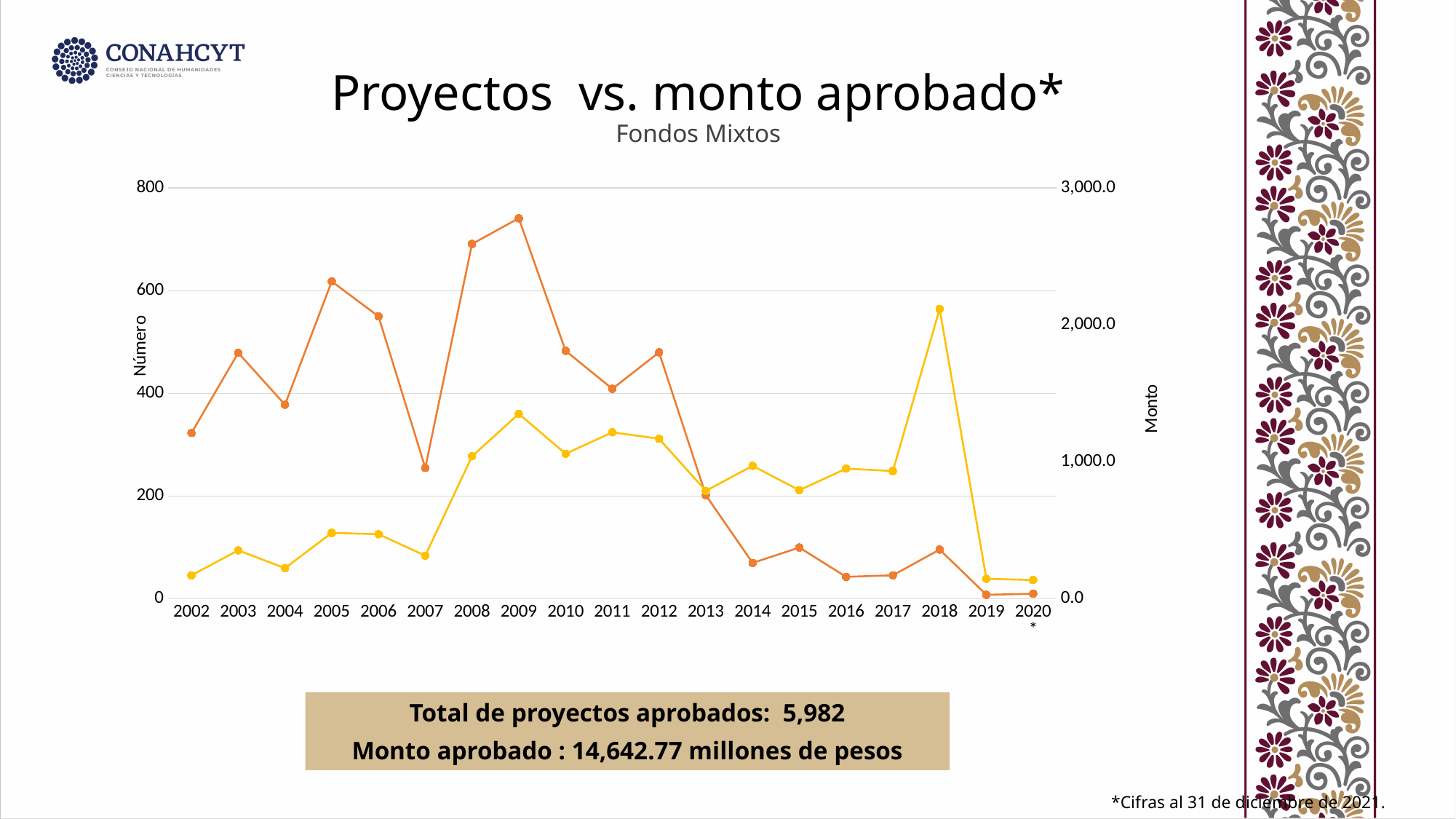
Is the value of the yellow line (Monto) for 2018 greater or less than 1,000.0? greater On the orange line (Número), which year has the higher value, 2005 or 2006? 2005 What is the label of the left vertical axis of the chart? Número Does the orange line (Número) rise or fall from 2012 to 2019? Fall In which year does the orange line (Número) reach its lowest point? 2019 What kind of chart is shown on the slide? Line chart Is the value of the orange line (Número) for 2009 greater or less than 600? greater Is the value of the yellow line (Monto) for 2002 greater or less than 1,000.0? less In which year does the yellow line (Monto) reach its highest point? 2018 How many years are plotted along the x axis of the chart? 19 In which year does the orange line (Número) reach its highest point? 2009